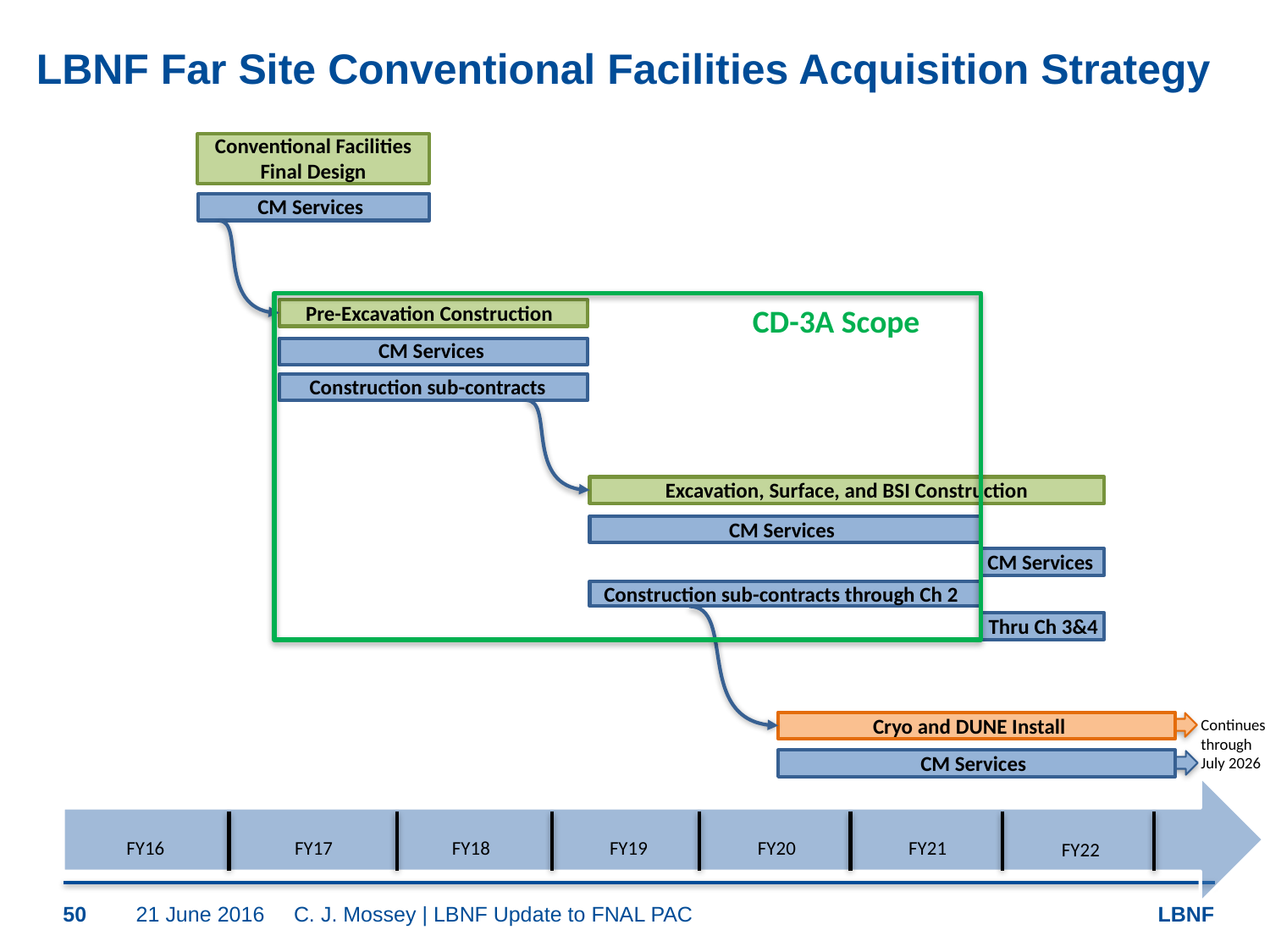
Through what date does the 'Cryo and DUNE Install' bar continue, according to the note at its right end? July 2026 What is the last fiscal year labelled on the timeline axis? FY22 Which bar on the slide is coloured orange? Cryo and DUNE Install How many fiscal years are labelled on the timeline axis at the bottom of the slide? 7 What is the label of the green box that encloses the middle group of bars? CD-3A Scope What is the first fiscal year labelled on the timeline axis? FY16 What kind of chart is shown on the slide? Timeline (Gantt-style schedule)